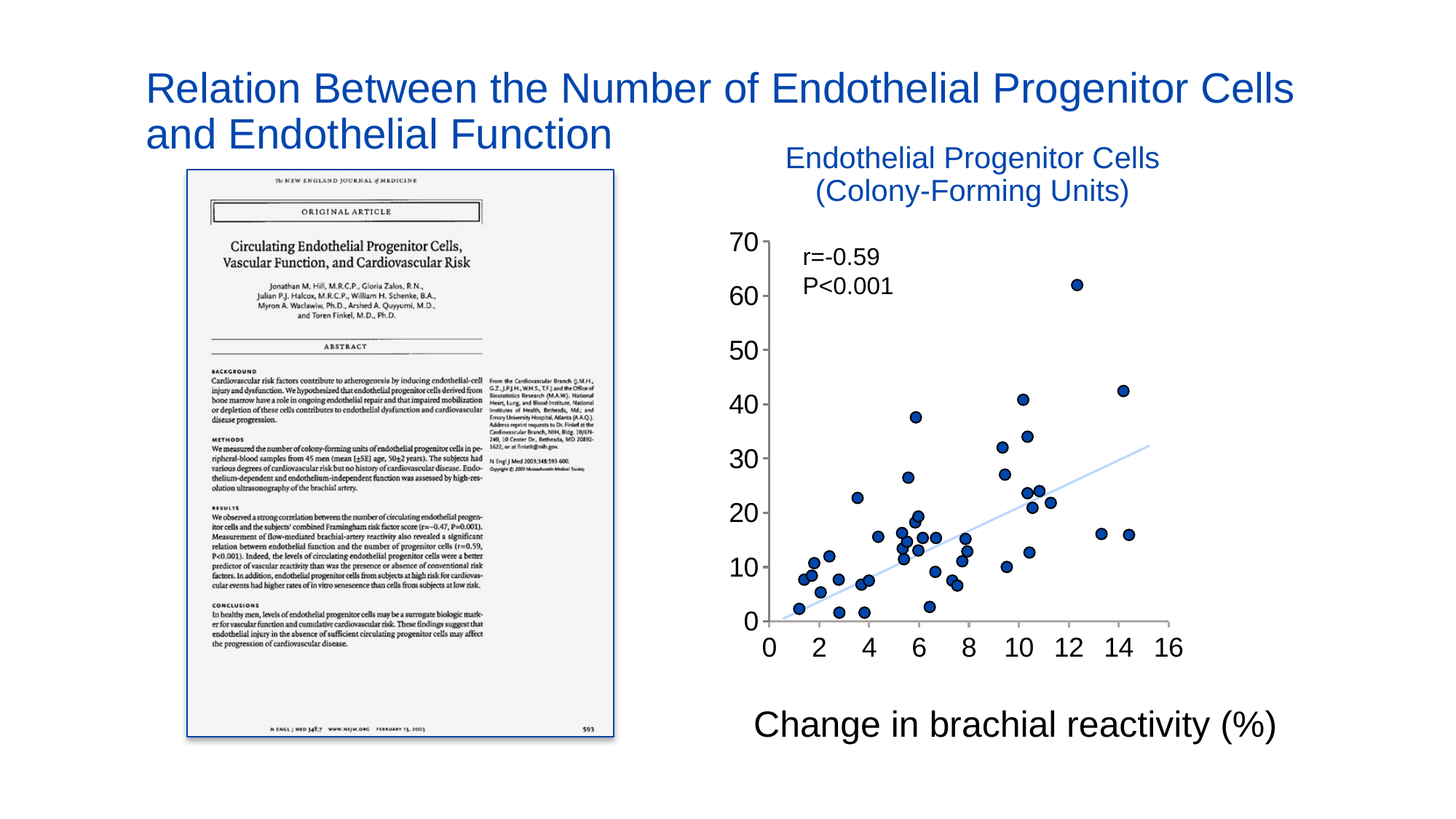
What P value is printed on the chart? P<0.001 What correlation coefficient is printed on the chart? r=-0.59 What kind of chart is shown on the slide? scatter chart Do the plotted values generally rise or fall as the change in brachial reactivity increases along the x axis? rise Is the highest plotted point on the chart greater or less than 60 colony-forming units? greater Is the lowest plotted point on the chart greater or less than 10 colony-forming units? less Is the highest plotted point on the chart greater or less than 70 colony-forming units? less